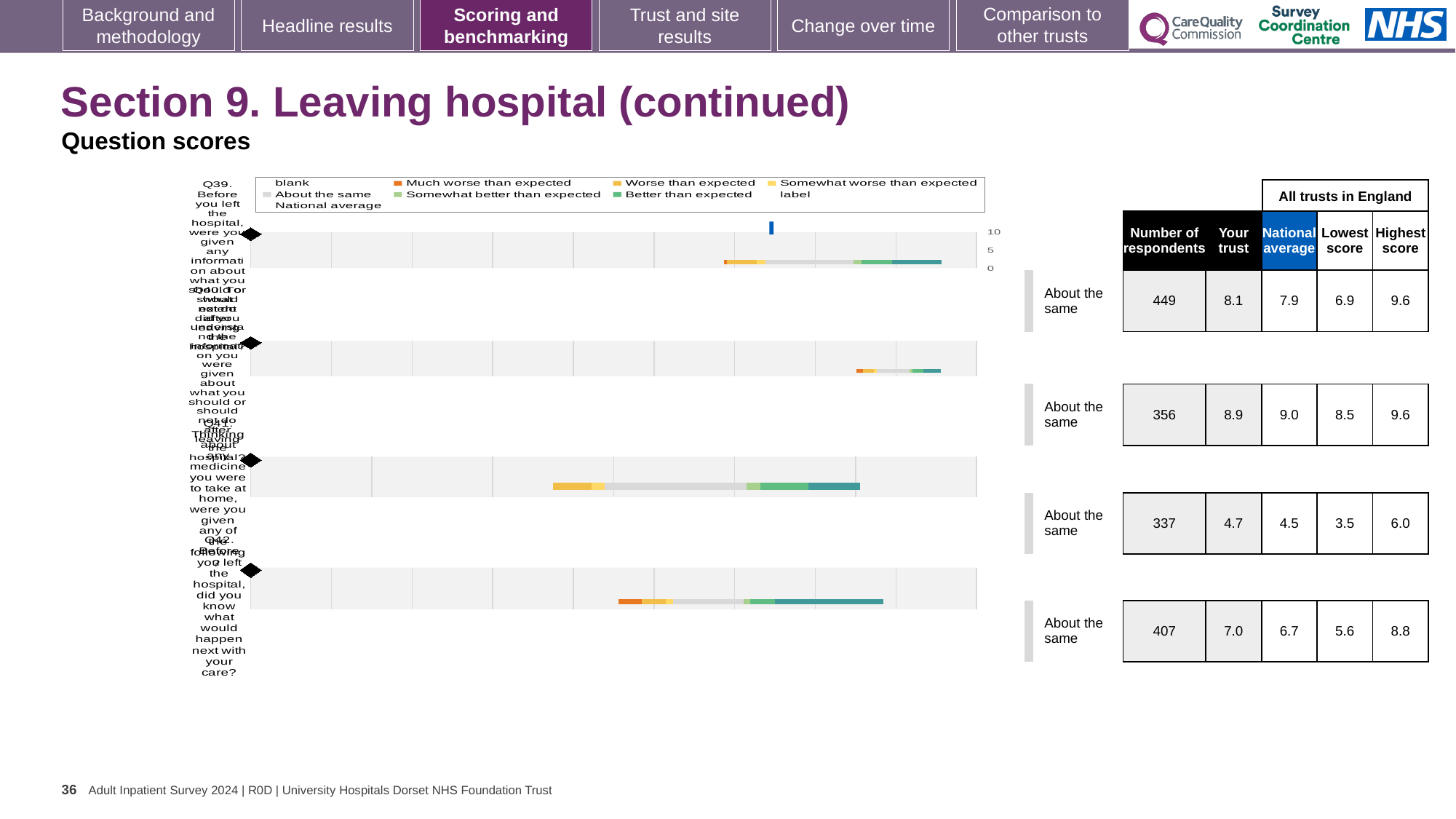
In the table beside the chart, which question has the highest 'Your trust' score? Q40 In the table beside the chart, which question has the fewest respondents? Q41 What kind of chart is shown on the slide? bar chart According to the table beside the chart, how many respondents answered Q39? 449 In the table beside the chart, what is the difference between the 'Your trust' score and the national average for Q42? 0.3 According to the table beside the chart, what is the national average score for Q42 (Before you left the hospital, did you know what would happen next with your care)? 6.7 In the table beside the chart, what is the difference between the highest score and the lowest score for Q41? 2.5 How many survey questions (rows) are plotted in the chart? 4 For Q39, which is larger in the table beside the chart: the 'Your trust' score or the national average? Your trust In the table beside the chart, which question has the lowest 'Your trust' score? Q41 According to the table beside the chart, what is the 'Your trust' score for Q39 (Before you left the hospital, were you given any information about what you should or should not do after leaving)? 8.1 What benchmark category is shown next to the chart for all four questions? About the same